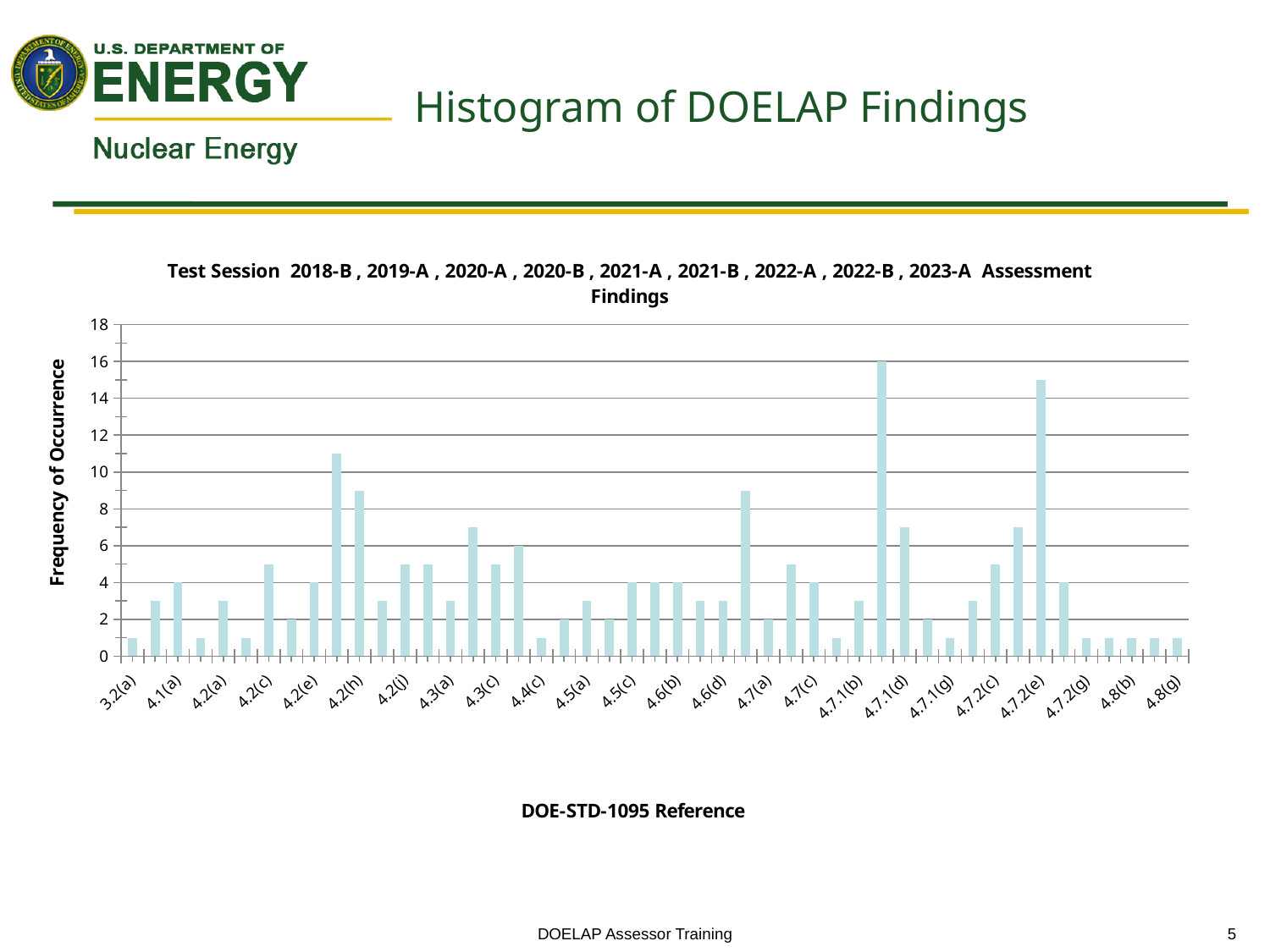
Is the value for 4.7.1(d) greater or less than 6? greater Is the value for 4.2(h) greater or less than 8? greater Is the value for 4.7.2(e) greater or less than 14? greater Which has a higher frequency of occurrence, 4.2(h) or 4.2(c)? 4.2(h) What kind of chart is shown on the slide? bar chart What is the frequency of occurrence reached by the tallest bar in the chart? 16 Which has a higher frequency of occurrence, 4.7.2(e) or 4.7.1(d)? 4.7.2(e) What is the x-axis title of the chart? DOE-STD-1095 Reference What is the y-axis title of the chart? Frequency of Occurrence What is the frequency of occurrence for 4.1(a)? 4